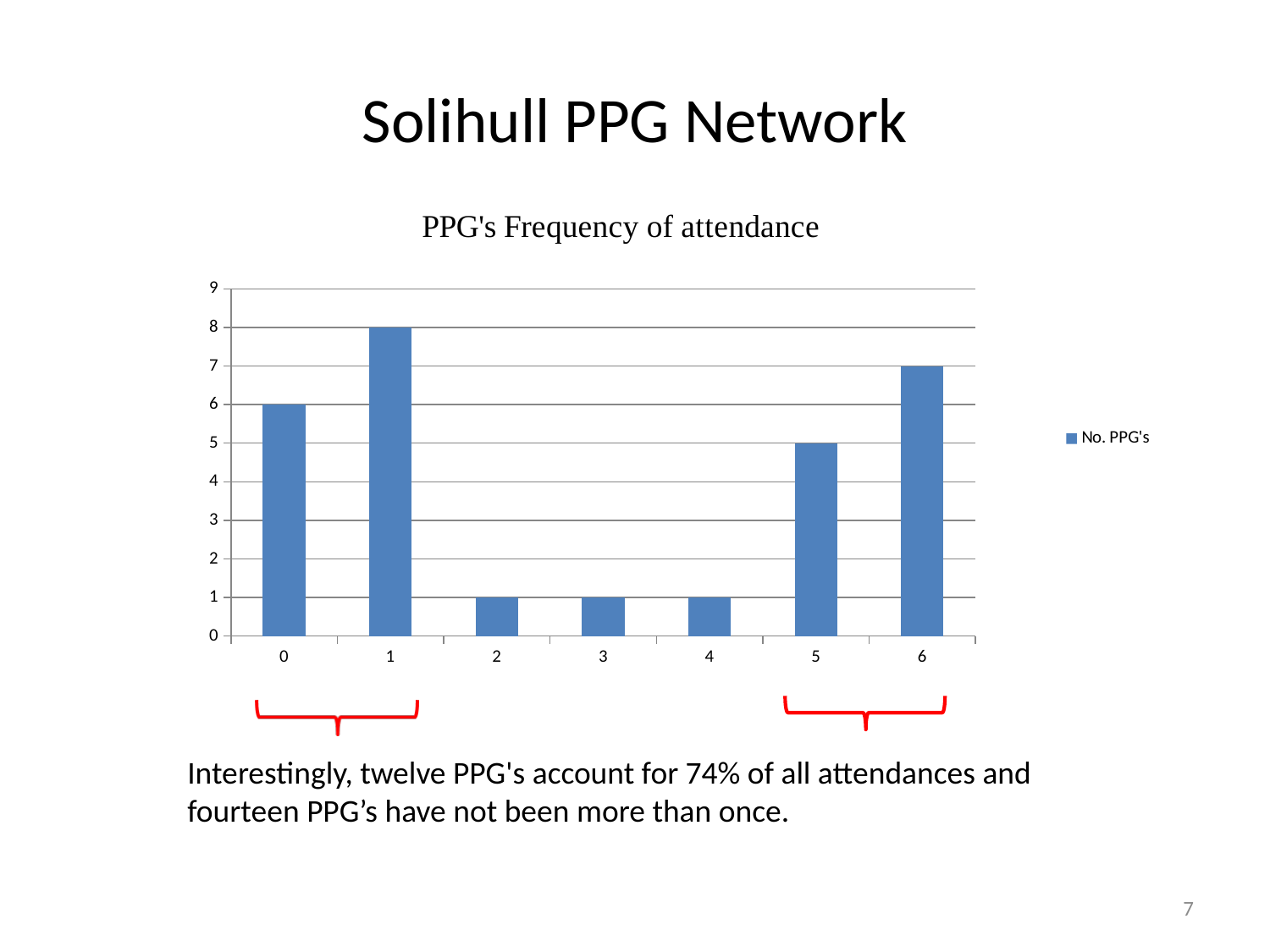
What is the difference between the values for category 1 and category 5? 3 What is the value of No. PPG's for category 6? 7 What is the name of the series shown in the legend? No. PPG's What is the value of No. PPG's for category 0? 6 Which category has the larger value, 5 or 6? 6 How many categories are shown on the x axis? 7 What type of chart is shown on the slide? Bar chart Is the value for category 5 greater or less than 4? greater Which category has the highest value? 1 What is the title of the chart? PPG's Frequency of attendance What is the value of No. PPG's for category 1? 8 How many series does the legend list? 1